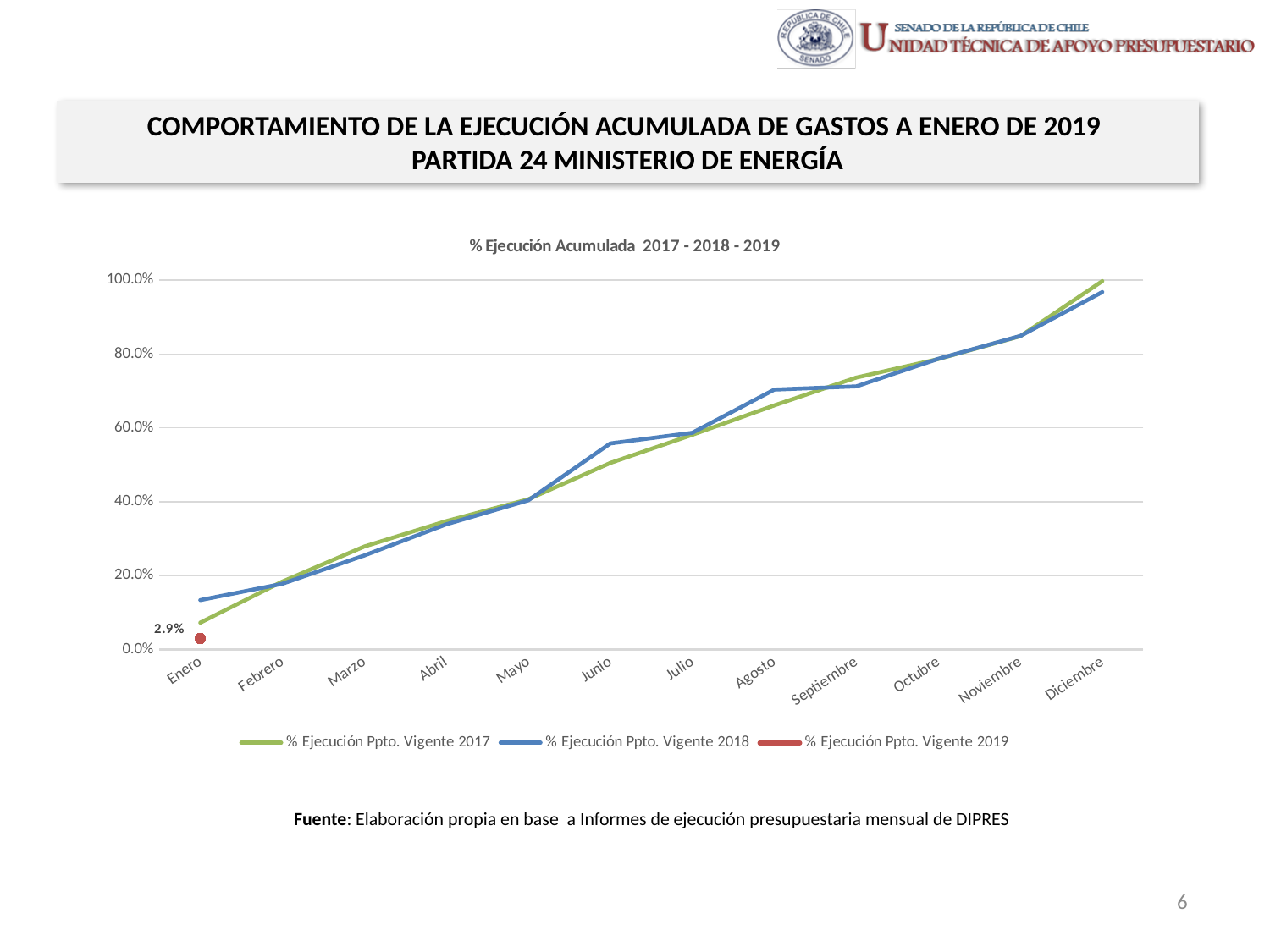
How many months are shown on the x axis? 12 Is the value for % Ejecución Ppto. Vigente 2018 in Junio greater or less than 40.0%? greater How many series does the legend list? 3 Which colour is used for the % Ejecución Ppto. Vigente 2019 series? red What type of chart is shown on the slide? line chart In Junio, which series has the larger value: % Ejecución Ppto. Vigente 2017 or % Ejecución Ppto. Vigente 2018? % Ejecución Ppto. Vigente 2018 In Enero, which series has the larger value: % Ejecución Ppto. Vigente 2018 or % Ejecución Ppto. Vigente 2019? % Ejecución Ppto. Vigente 2018 Is the value for % Ejecución Ppto. Vigente 2018 in Noviembre greater or less than 80.0%? greater What is the value for % Ejecución Ppto. Vigente 2019 in Enero? 2.9% What is the title of the chart? % Ejecución Acumulada 2017 - 2018 - 2019 Do the values for % Ejecución Ppto. Vigente 2018 rise or fall from Enero to Diciembre? rise Is the value for % Ejecución Ppto. Vigente 2017 in Marzo greater or less than 40.0%? less